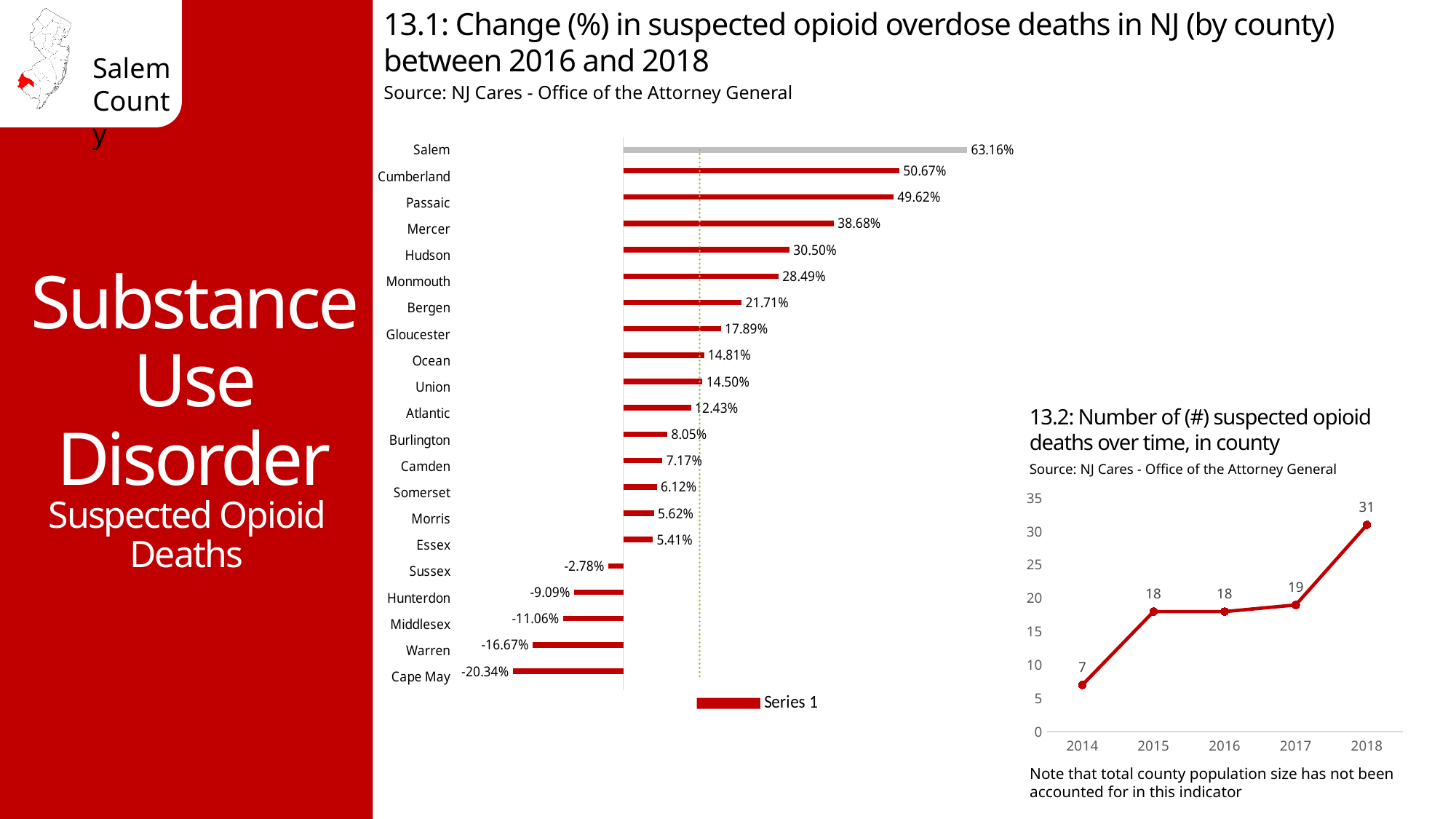
In chart 13.1, which has a larger value, Mercer or Hudson? Mercer In chart 13.1, what is the value for Cape May? -20.34% In chart 13.1 (Change (%) in suspected opioid overdose deaths in NJ by county), what is the value for Salem? 63.16% In chart 13.2, do the values generally rise or fall from 2014 to 2018? Rise In chart 13.1, what is the difference between the values for Cumberland and Passaic? 1.05% In chart 13.1, how many counties are shown? 21 What kind of chart is chart 13.2? Line chart In chart 13.2, what is the difference between the values for 2017 and 2018? 12 What kind of chart is chart 13.1? Bar chart In chart 13.1, which county has the highest percentage change? Salem In chart 13.1, which county has the lowest percentage change? Cape May In chart 13.2 (Number of suspected opioid deaths over time, in county), what is the value for 2018? 31